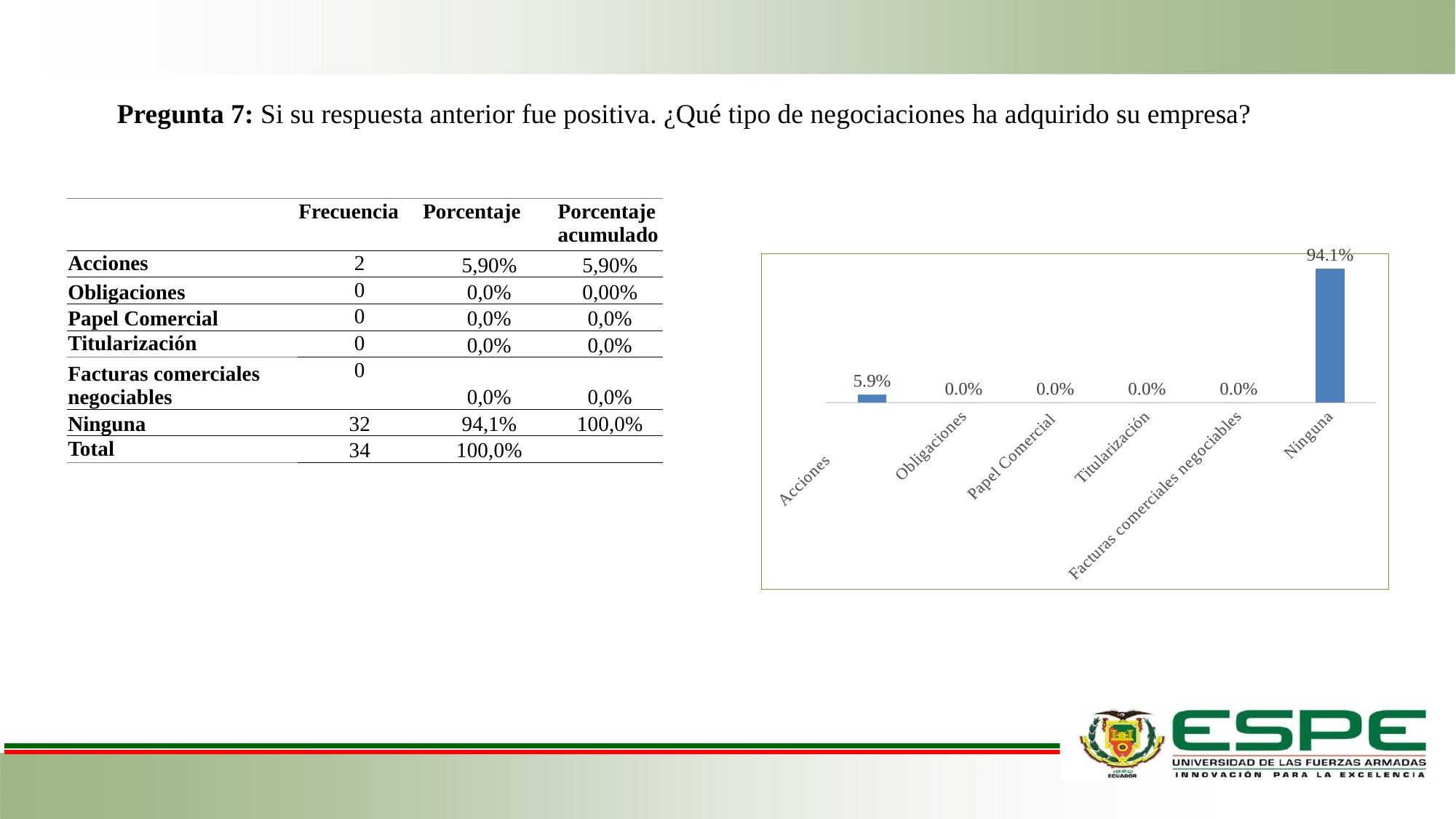
Which category has the highest value in the chart? Ninguna What is the difference between the values for Ninguna and Acciones in the chart? 88.2% What colour are the bars in the chart? blue What is the value shown for Acciones in the chart? 5.9% What is the value shown for Ninguna in the chart? 94.1% How many categories in the chart have a value of 0.0%? 4 How many categories are shown on the x axis of the chart? 6 Which is larger in the chart, the value for Acciones or the value for Obligaciones? Acciones What is the total of the values for Acciones and Ninguna in the chart? 100.0% What is the value shown for Papel Comercial in the chart? 0.0% What kind of chart is shown on the slide? bar chart What is the value shown for Titularización in the chart? 0.0%